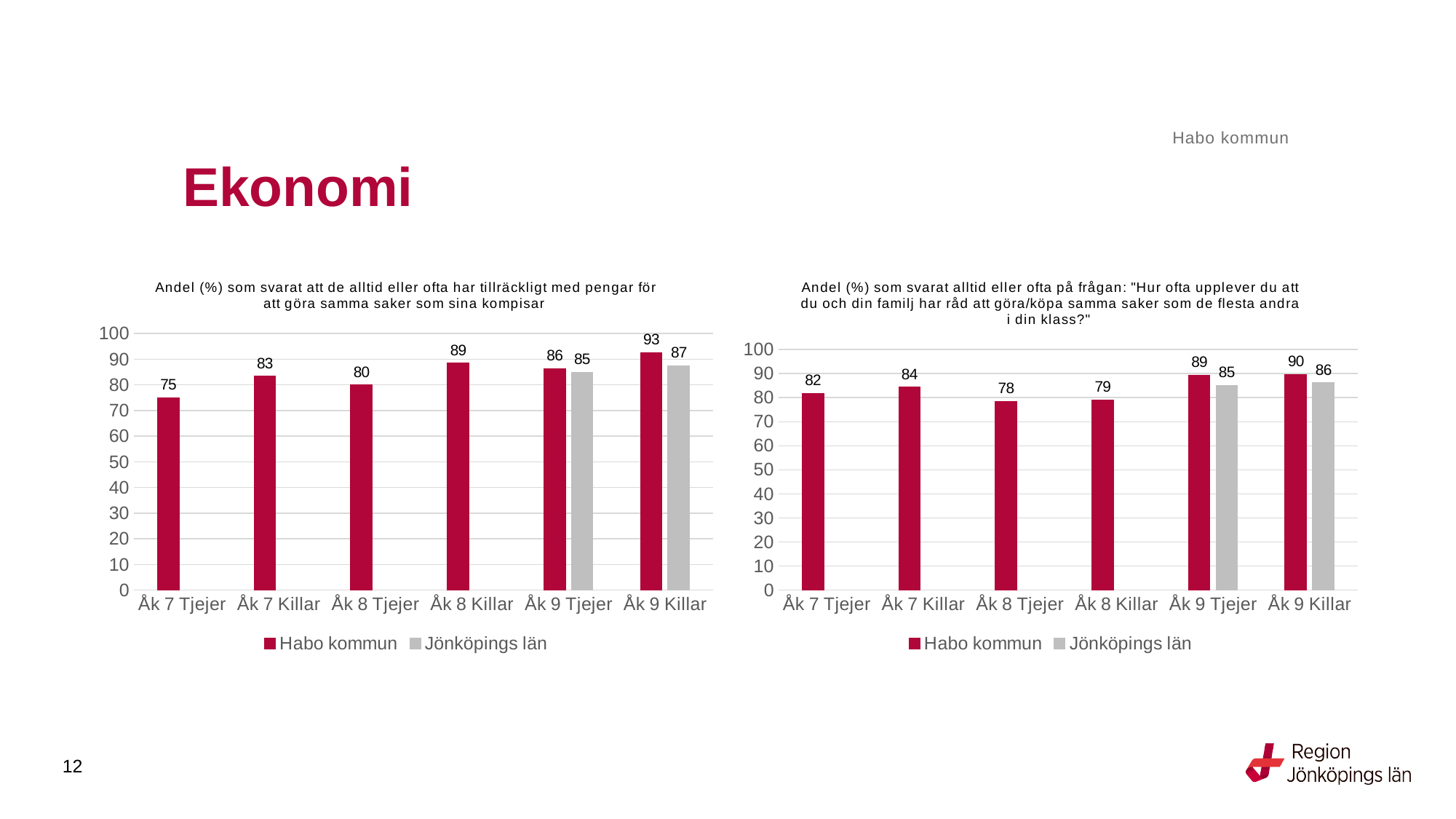
What kind of chart is the right chart? Bar chart In the left chart, what is the difference between the Habo kommun values for Åk 8 Killar and Åk 8 Tjejer? 9 In the right chart, how many categories are shown on the x axis? 6 In the right chart, what is the value for Habo kommun for Åk 8 Tjejer? 78 In the left chart, what is the value for Habo kommun for Åk 7 Tjejer? 75 In the left chart, how many series does the legend list? 2 In the left chart, what is the value for Jönköpings län for Åk 9 Killar? 87 In the left chart, which category has the highest Habo kommun value? Åk 9 Killar In the right chart, which category has the lowest Habo kommun value? Åk 8 Tjejer In the left chart, which category has the lowest Habo kommun value? Åk 7 Tjejer In the right chart, which is larger for Åk 9 Killar: Habo kommun or Jönköpings län? Habo kommun In the right chart, what is the value for Jönköpings län for Åk 9 Tjejer? 85